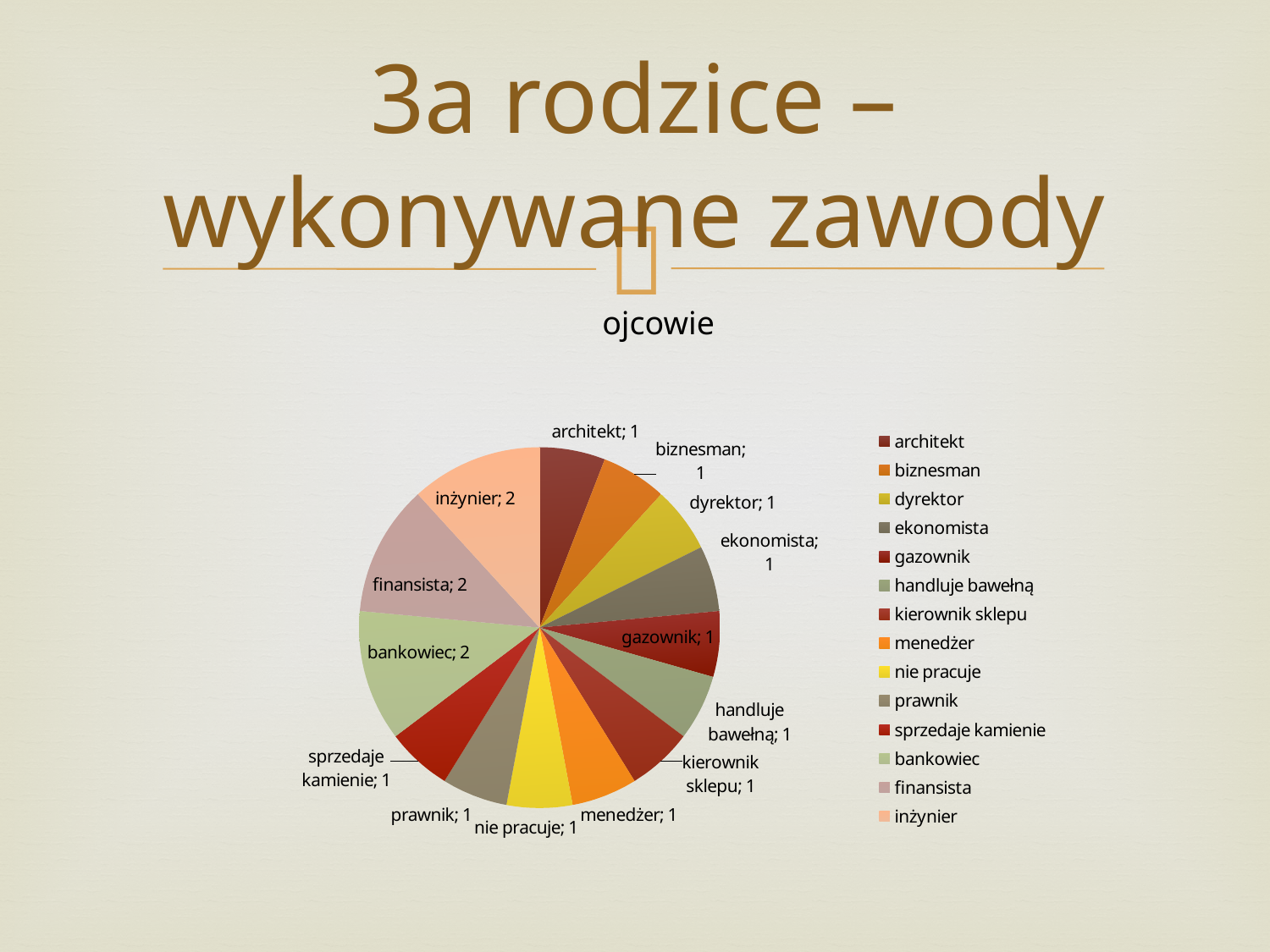
Which categories have the highest value in the pie chart? bankowiec, finansista, inżynier What is the value for inżynier? 2 How many categories does the pie chart have? 14 What is the difference between the value for inżynier and the value for architekt? 1 What is the value for nie pracuje? 1 What is the title of the chart? ojcowie What is the value for bankowiec? 2 Which legend entry is listed last? inżynier What is the total of all the values in the pie chart? 17 What type of chart is shown on the slide? pie chart What is the value for gazownik? 1 Which is larger, the value for finansista or the value for prawnik? finansista